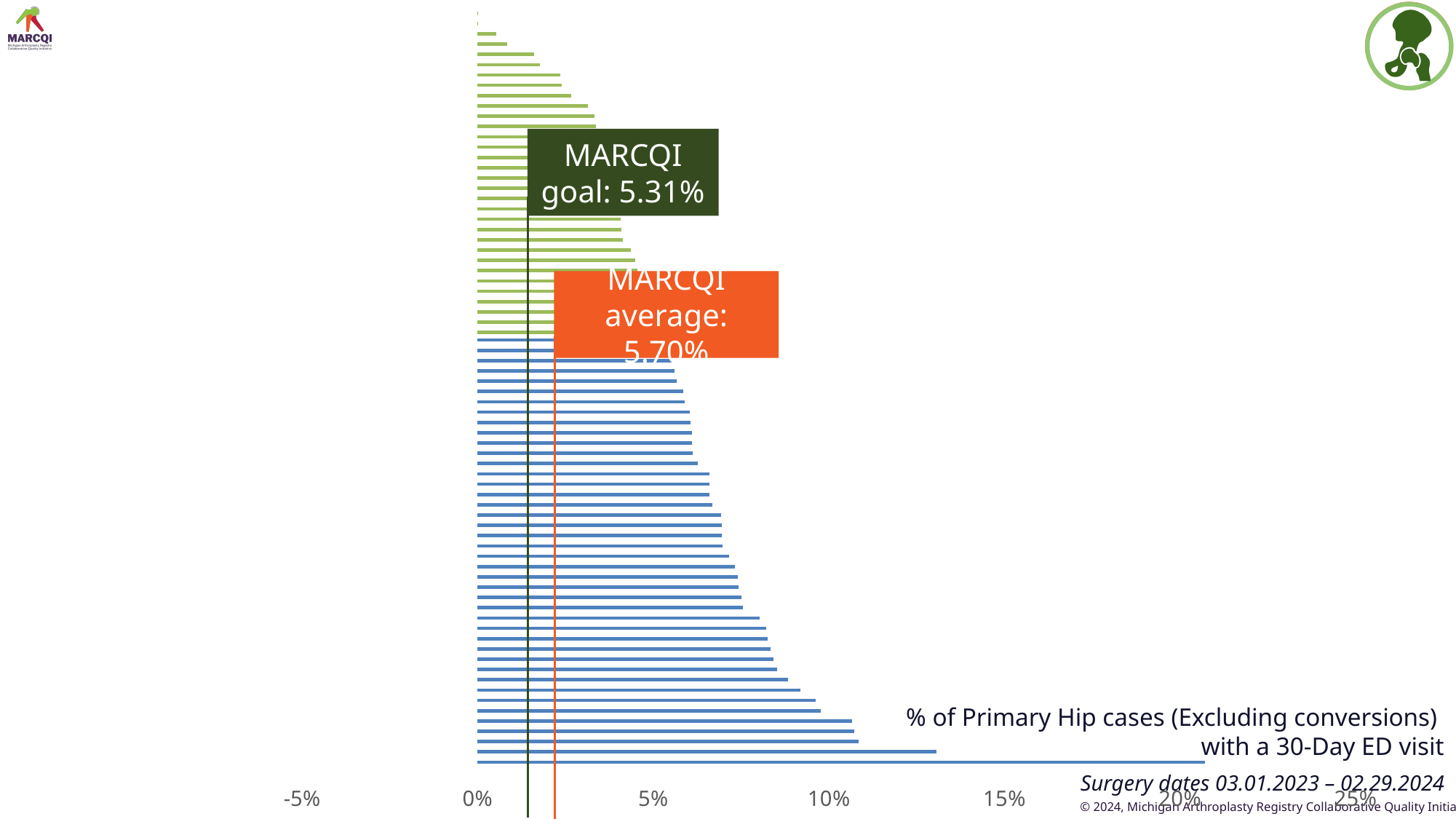
Is the value of the longest bar greater or less than 15%? greater What surgery date range does the chart cover? 03.01.2023 – 02.29.2024 Which is larger, the MARCQI average or the MARCQI goal? MARCQI average What is the MARCQI average value shown on the chart? 5.70% What is the MARCQI goal value shown on the chart? 5.31% What is the highest value labelled on the horizontal axis? 25% What kind of chart is shown on the slide? bar chart Is the value of the second-longest bar greater or less than 10%? greater Do the bar values increase or decrease going from the top of the chart to the bottom? increase Is the MARCQI average greater or less than 5%? greater What is the title of the chart? % of Primary Hip cases (Excluding conversions) with a 30-Day ED visit By how much does the MARCQI average exceed the MARCQI goal? 0.39%